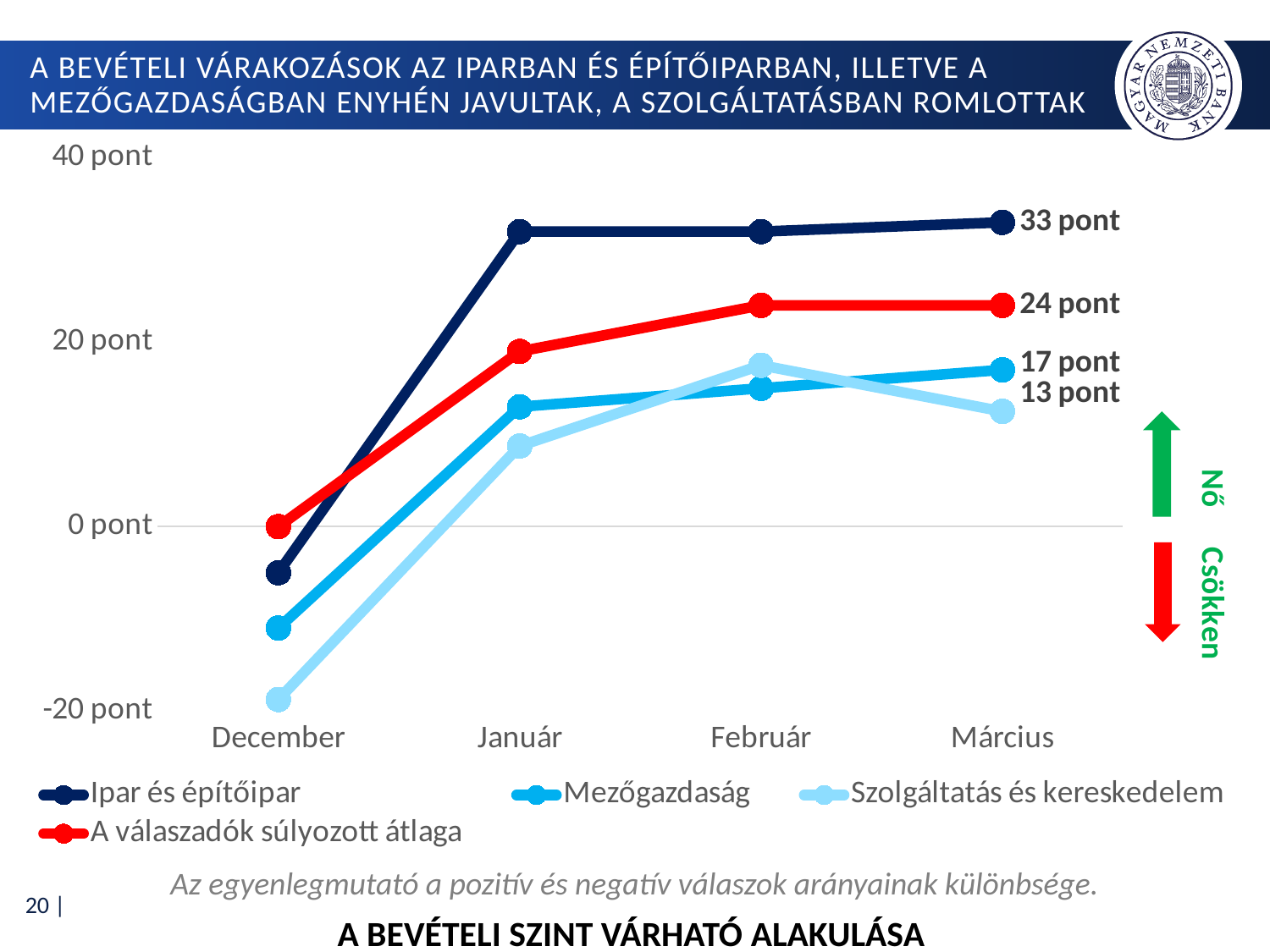
How many series does the legend list? 4 Which series has the highest value in Március? Ipar és építőipar Is the value for Ipar és építőipar in December greater or less than 0 pont? less Which is larger in Március: Mezőgazdaság or Szolgáltatás és kereskedelem? Mezőgazdaság What is the value for Ipar és építőipar in Március? 33 pont Which series has the lowest value in Március? Szolgáltatás és kereskedelem What kind of chart is shown on the slide? line chart How many months are shown on the x axis? 4 What is the value for A válaszadók súlyozott átlaga in Március? 24 pont What is the value for Mezőgazdaság in Március? 17 pont What is the value for Szolgáltatás és kereskedelem in Március? 13 pont What is the difference between Ipar és építőipar and Szolgáltatás és kereskedelem in Március? 20 pont